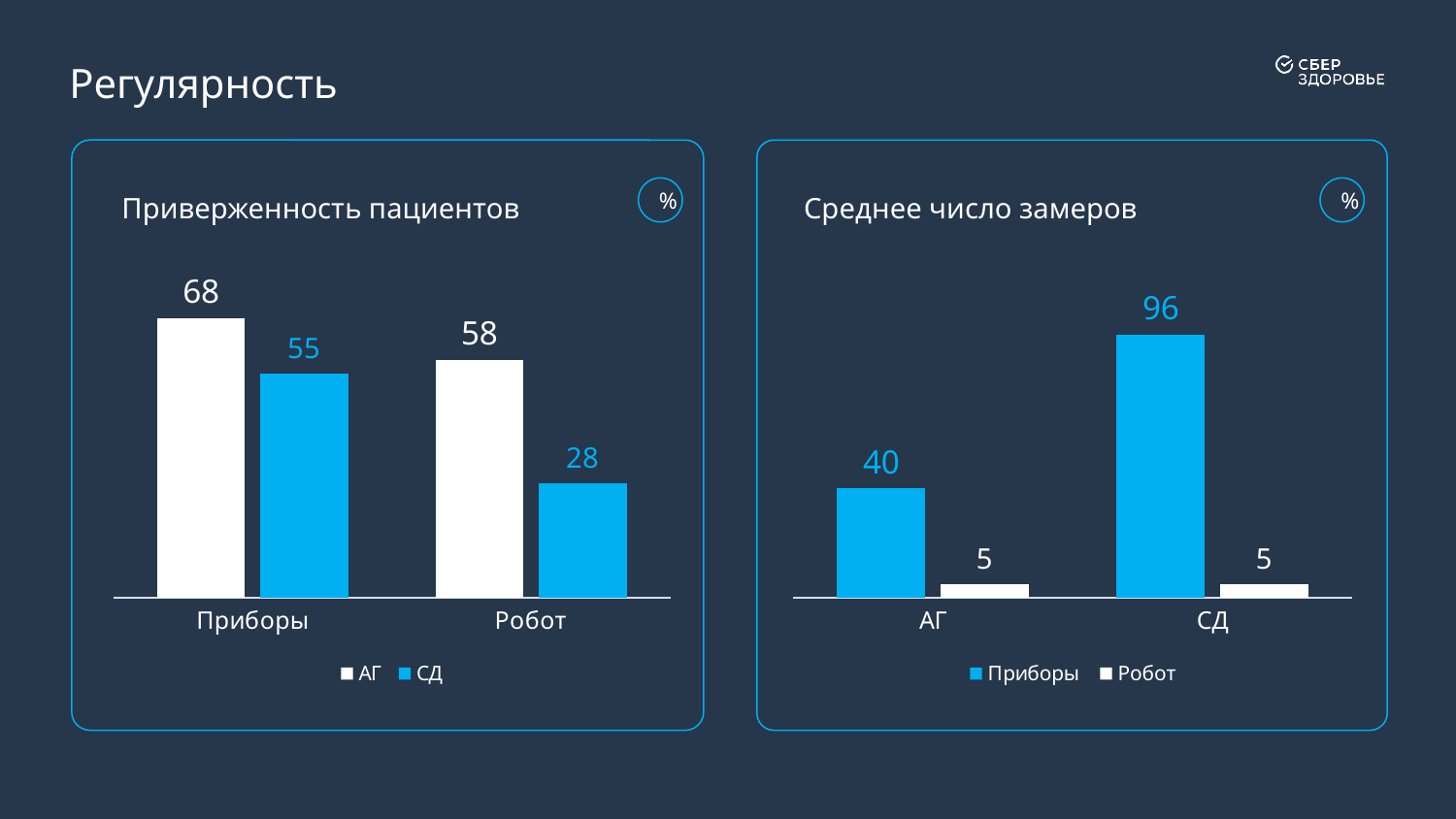
In the chart titled "Приверженность пациентов", how many series does the legend list? 2 What kind of chart is the chart titled "Среднее число замеров"? Bar chart In the chart titled "Приверженность пациентов", which is larger: the АГ value for Приборы or the АГ value for Робот? Приборы In the chart titled "Среднее число замеров", what is the value for Приборы in the СД category? 96 In the chart titled "Приверженность пациентов", what is the value for АГ in the Приборы category? 68 In the chart titled "Приверженность пациентов", what is the difference between the АГ and СД values for Робот? 30 In the chart titled "Приверженность пациентов", what is the value for СД in the Робот category? 28 In the chart titled "Приверженность пациентов", which category has the highest СД value? Приборы In the chart titled "Среднее число замеров", which category has the lowest Приборы value? АГ In the chart titled "Среднее число замеров", what is the value for Робот in the АГ category? 5 In the chart titled "Среднее число замеров", what colour are the Приборы bars? Blue In the chart titled "Среднее число замеров", what is the difference between the Приборы values for СД and АГ? 56